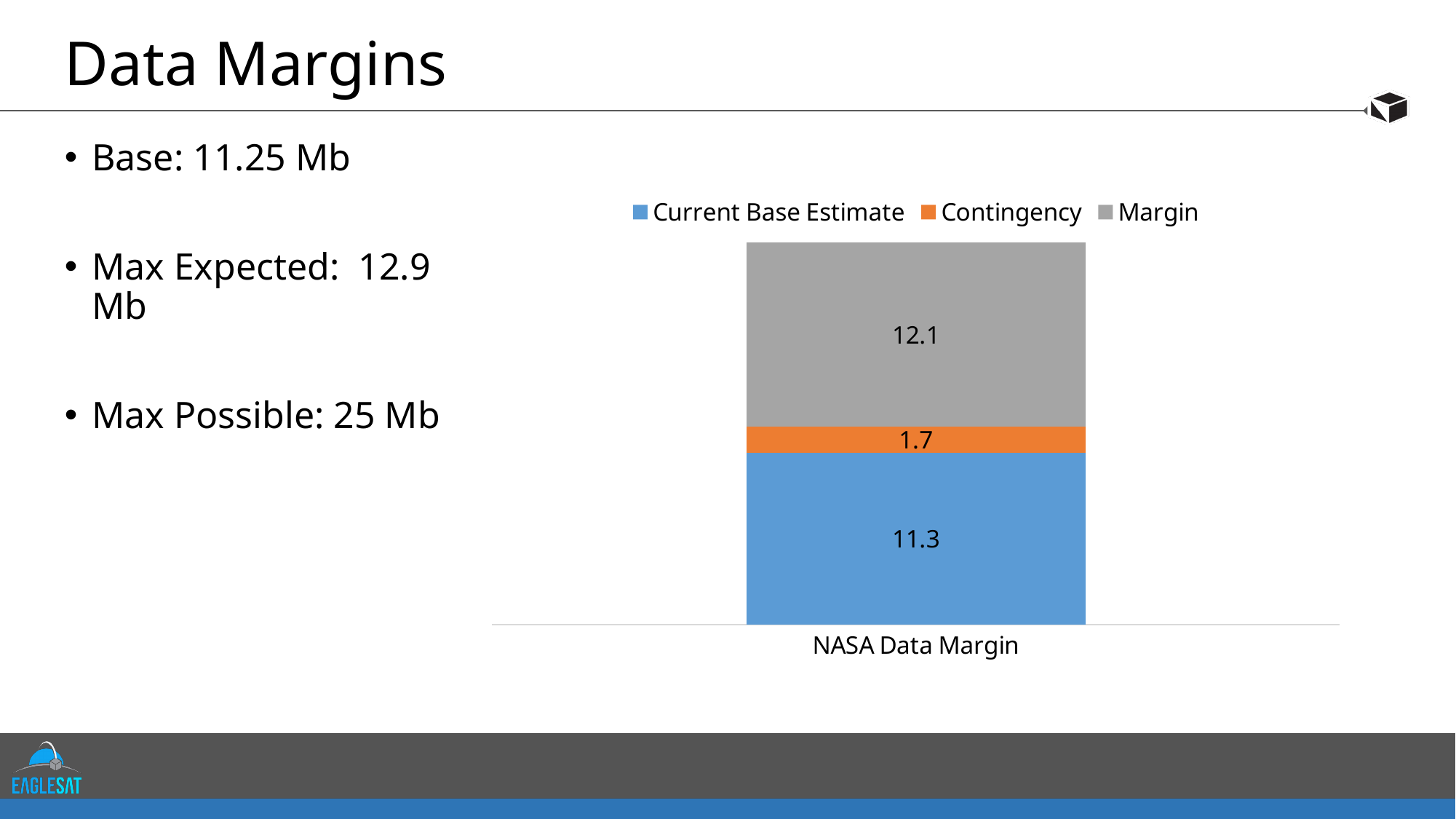
Which series has the smallest segment in the NASA Data Margin bar? Contingency What is the value of the Current Base Estimate segment for NASA Data Margin? 11.3 How many categories are shown on the x axis? 1 Which series has the largest segment in the NASA Data Margin bar? Margin What kind of chart is shown on the slide? Stacked bar chart What is the total of the stacked NASA Data Margin bar? 25.1 What is the value of the Margin segment for NASA Data Margin? 12.1 What is the difference between the Current Base Estimate and Contingency values? 9.6 Which is larger, the Margin segment or the Contingency segment? Margin How many series does the legend list? 3 What is the value of the Contingency segment for NASA Data Margin? 1.7 What is the difference between the Margin and Current Base Estimate values? 0.8